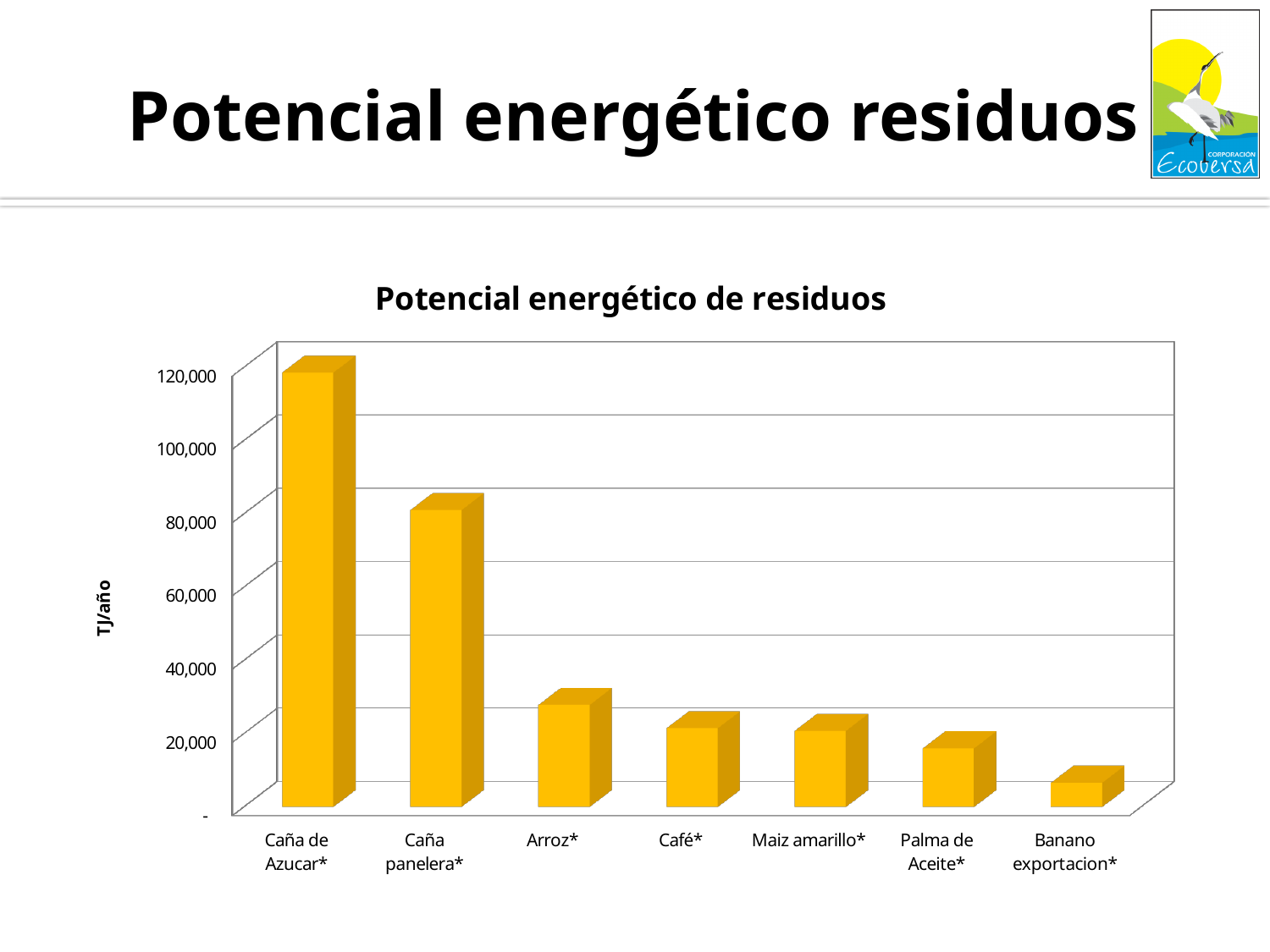
Is the value for Caña panelera* greater or less than 60,000? greater What unit is shown on the vertical axis of the chart? TJ/año Is the value for Arroz* greater or less than 40,000? less What is the title of the chart? Potencial energético de residuos Is the value for Caña de Azucar* greater or less than 100,000? greater What kind of chart is shown on the slide? bar chart Which is larger, the value for Caña panelera* or the value for Arroz*? Caña panelera* How many categories are plotted in the chart? 7 Which category has the highest value in the chart? Caña de Azucar* Which is larger, the value for Arroz* or the value for Banano exportacion*? Arroz* Do the values generally rise or fall moving from left to right along the x axis? fall Which category has the lowest value in the chart? Banano exportacion*